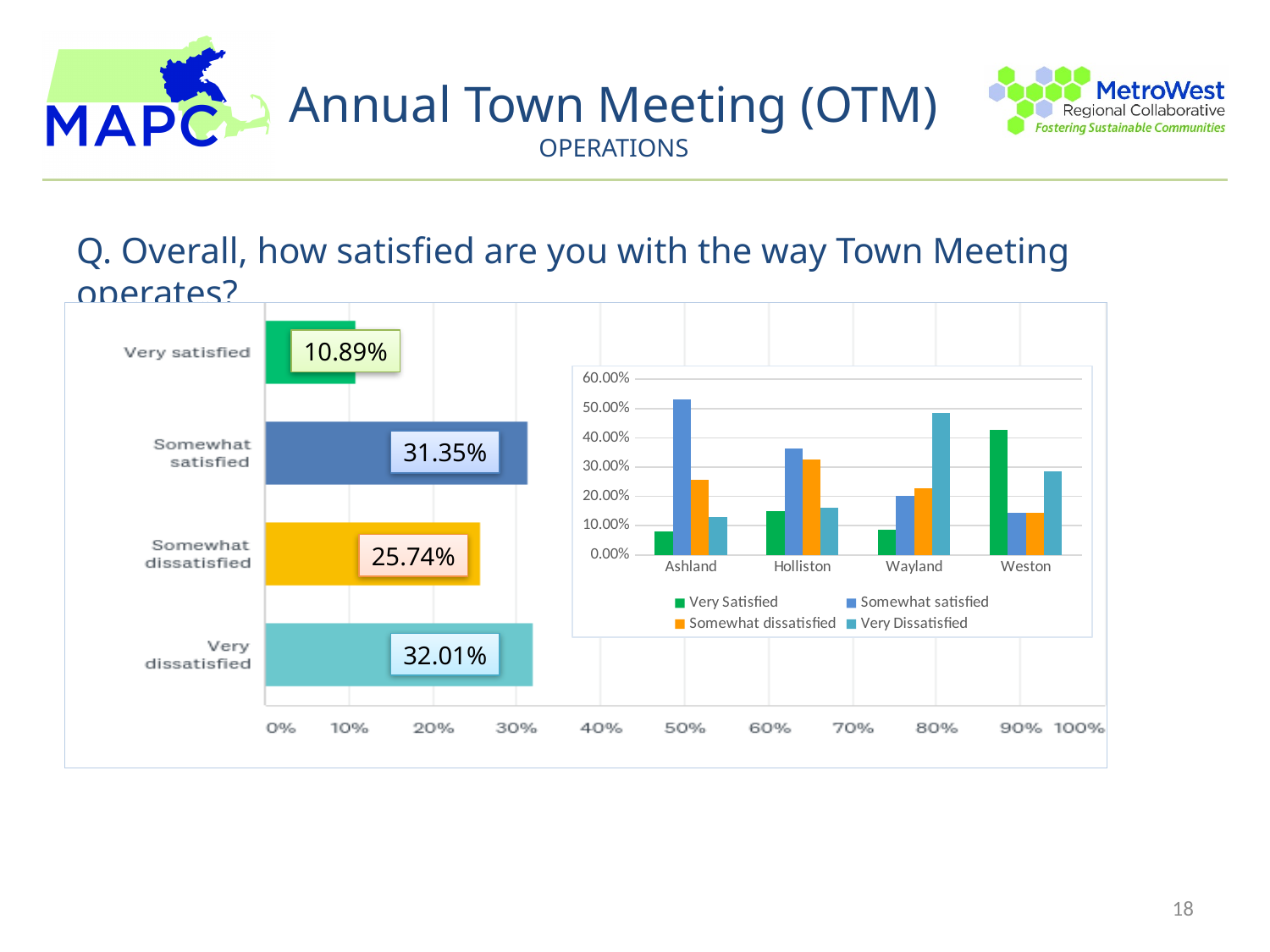
What type of chart is the chart on the right showing Ashland, Holliston, Wayland and Weston? Bar chart In the horizontal bar chart on the left, which is larger: Somewhat satisfied or Somewhat dissatisfied? Somewhat satisfied In the horizontal bar chart on the left, which response category has the highest percentage? Very dissatisfied In the chart on the right, which town has the highest Very Dissatisfied value? Wayland In the horizontal bar chart on the left, what percentage of respondents were Very satisfied? 10.89% In the chart on the right, is the Somewhat satisfied value for Ashland greater or less than 50.00%? greater In the horizontal bar chart on the left, which response category has the lowest percentage? Very satisfied In the chart on the right, which town has the highest Very Satisfied value? Weston In the horizontal bar chart on the left, what percentage of respondents were Somewhat dissatisfied? 25.74% How many response categories are shown in the horizontal bar chart on the left? 4 How many series does the legend of the chart on the right list? 4 In the horizontal bar chart on the left, what is the difference between the Somewhat satisfied and Very satisfied percentages? 20.46%